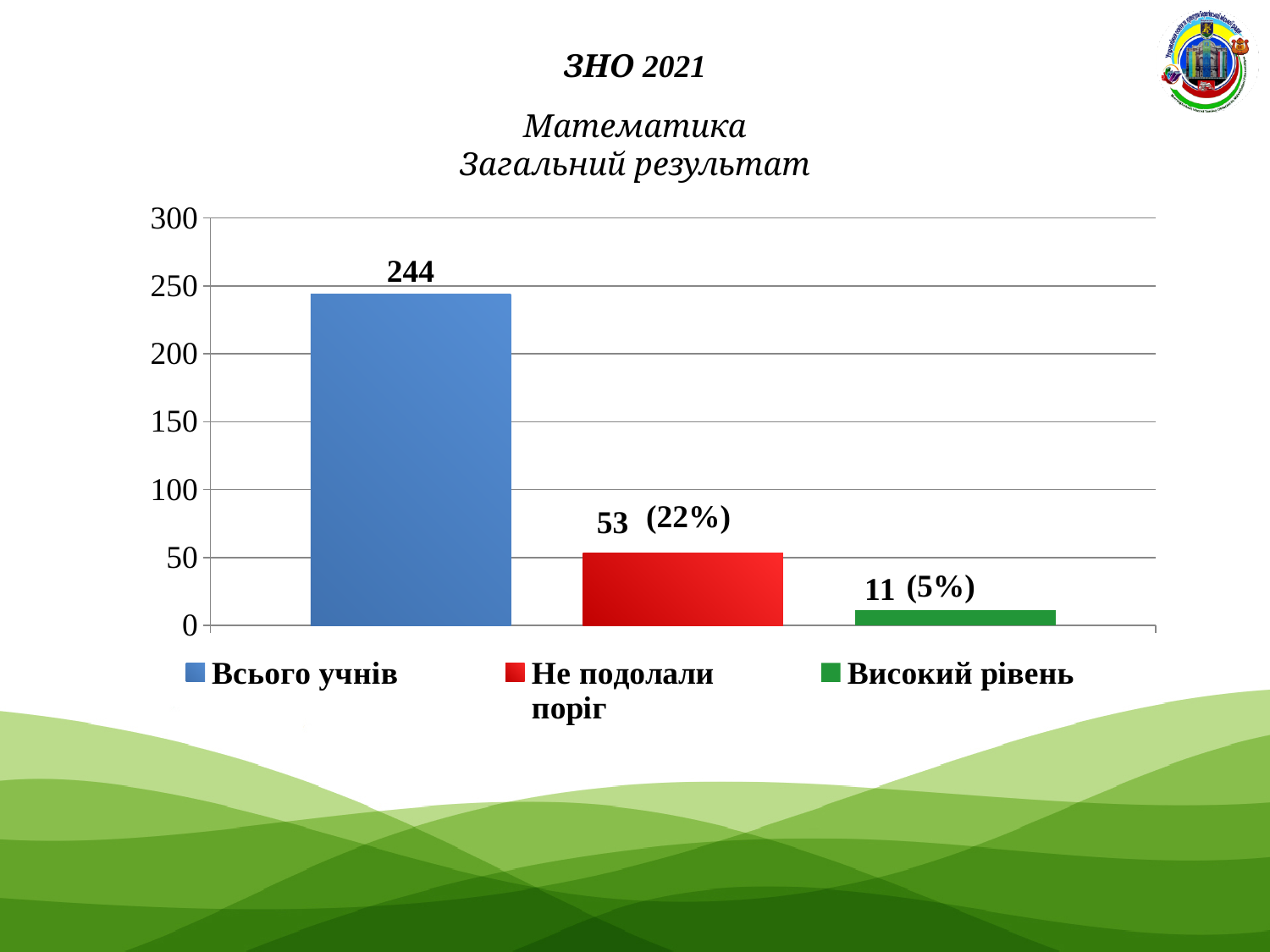
Which category has the highest value? Всього учнів What is the value for Високий рівень? 11 What kind of chart is shown on the slide? bar chart What is the difference between Всього учнів and Не подолали поріг? 191 What is the value for Не подолали поріг? 53 What is the value for Всього учнів? 244 What percentage is shown next to the value for Не подолали поріг? 22% How many bars are shown in the chart? 3 What is the difference between Не подолали поріг and Високий рівень? 42 Is the value for Всього учнів greater or less than 200? greater Which is larger, Не подолали поріг or Високий рівень? Не подолали поріг Which category has the lowest value? Високий рівень